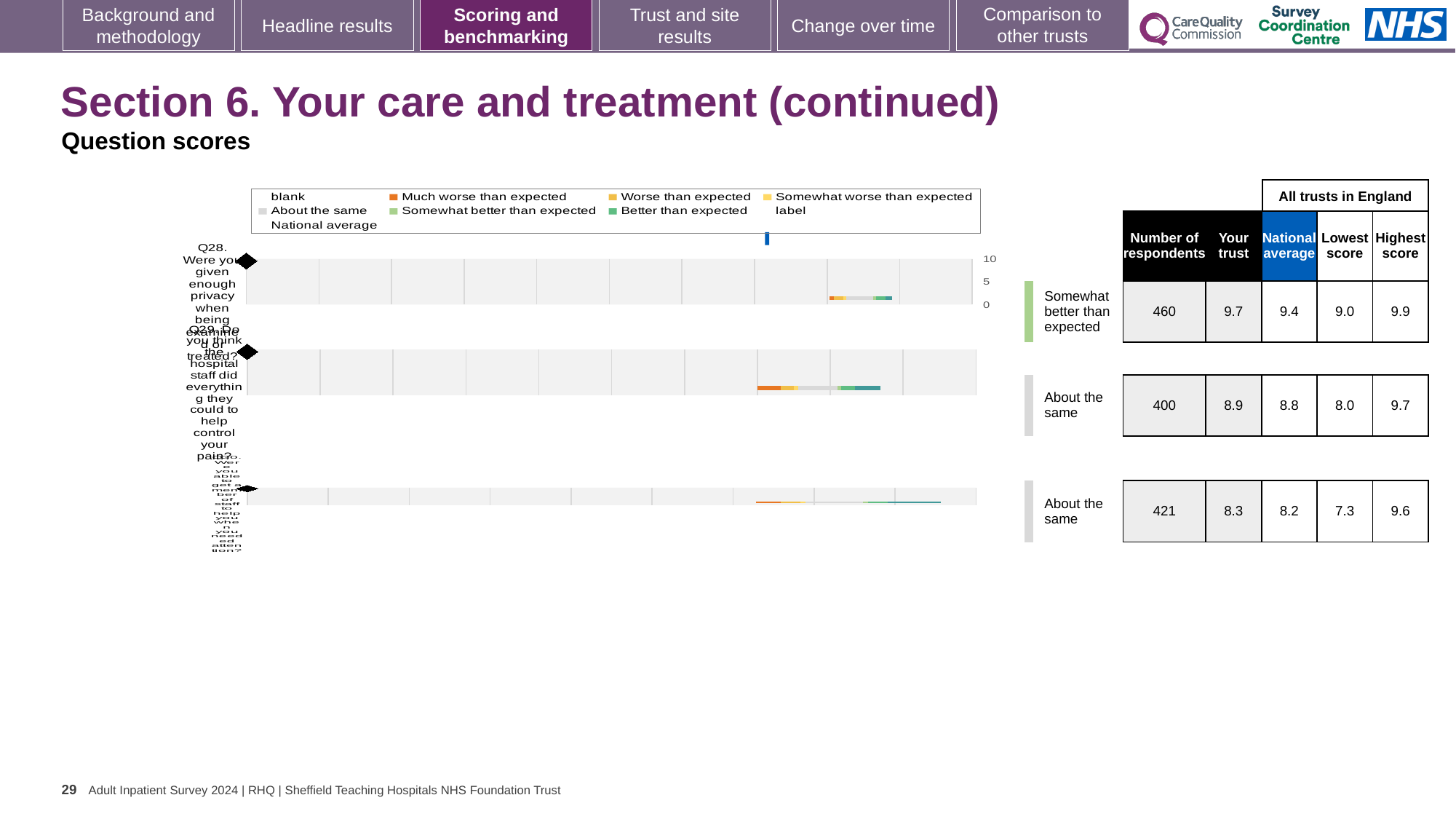
What kind of chart is shown on the slide? bar chart Is the value for Q28 greater or less than 5 on the score axis? greater What is the national average score for Q29 (hospital staff helping to control pain)? 8.8 How many respondents answered Q30? 421 Which question has the lowest 'Your trust' score? Q30 For Q29, which is larger: the 'Your trust' score or the national average? Your trust What is the difference between the 'Your trust' score and the national average for Q28? 0.3 Which question has the highest 'Your trust' score? Q28 How many questions (categories) are plotted in the chart? 3 What is the highest value shown on the chart's score axis? 10 What benchmark category is shown for Q28? Somewhat better than expected What is the 'Your trust' score for Q28 (privacy when being examined or treated)? 9.7